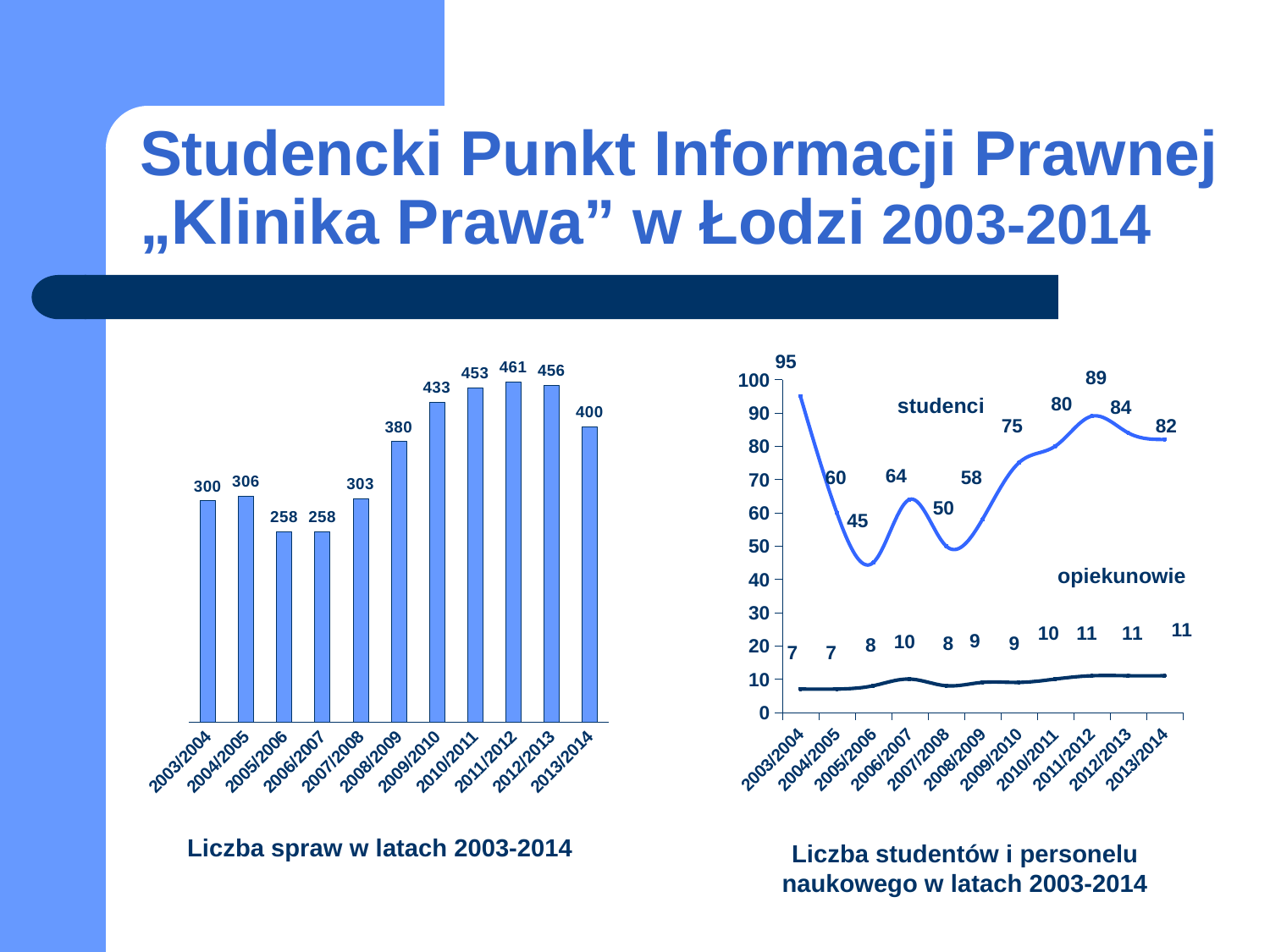
What kind of chart is the right chart (Liczba studentów i personelu naukowego)? line chart In the left chart (Liczba spraw w latach 2003-2014), which academic year has the highest value? 2011/2012 In the left chart (Liczba spraw w latach 2003-2014), what is the difference between the values for 2011/2012 and 2013/2014? 61 In the right chart (Liczba studentów i personelu naukowego), in which academic year is the studenci value lowest? 2005/2006 In the left chart (Liczba spraw w latach 2003-2014), how many academic years are shown on the x axis? 11 In the left chart (Liczba spraw w latach 2003-2014), which is larger, the value for 2004/2005 or the value for 2007/2008? 2004/2005 In the right chart (Liczba studentów i personelu naukowego), what is the value for studenci in 2003/2004? 95 How many series are plotted in the right chart (Liczba studentów i personelu naukowego)? 2 In the right chart (Liczba studentów i personelu naukowego), what is the difference between the studenci value and the opiekunowie value in 2013/2014? 71 What kind of chart is the left chart (Liczba spraw w latach 2003-2014)? bar chart In the left chart (Liczba spraw w latach 2003-2014), what is the value for 2009/2010? 433 In the right chart (Liczba studentów i personelu naukowego), what is the value for opiekunowie in 2006/2007? 10